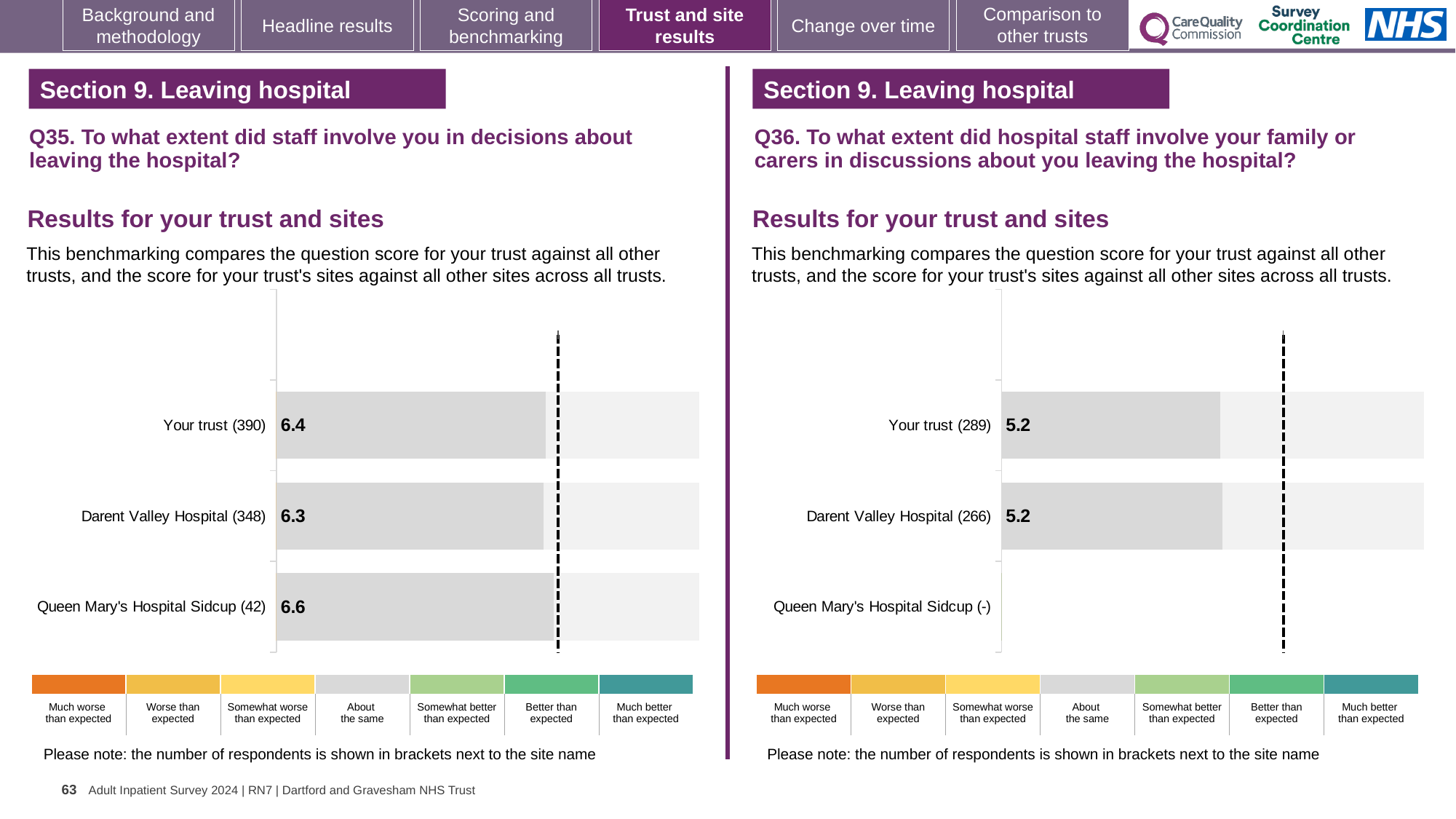
In the Q35 chart on the left, what is the score for Queen Mary's Hospital Sidcup? 6.6 In the Q35 chart on the left, which has the larger score, Your trust or Queen Mary's Hospital Sidcup? Queen Mary's Hospital Sidcup In the Q35 chart on the left, what is the difference between the scores for Queen Mary's Hospital Sidcup and Darent Valley Hospital? 0.3 How many categories (trust and sites) are listed in the Q35 chart on the left? 3 In the Q35 chart on the left, how many respondents are shown in brackets for Your trust? 390 In the Q35 chart on the left, what is the score for Your trust? 6.4 What kind of chart is the Q36 chart on the right? Bar chart In the Q35 chart on the left, which site or trust has the lowest score? Darent Valley Hospital In the Q36 chart on the right, what is the score for Darent Valley Hospital? 5.2 In the Q35 chart on the left, which site or trust has the highest score? Queen Mary's Hospital Sidcup In the Q36 chart on the right, what is the score for Your trust? 5.2 In the Q35 chart on the left, what is the score for Darent Valley Hospital? 6.3